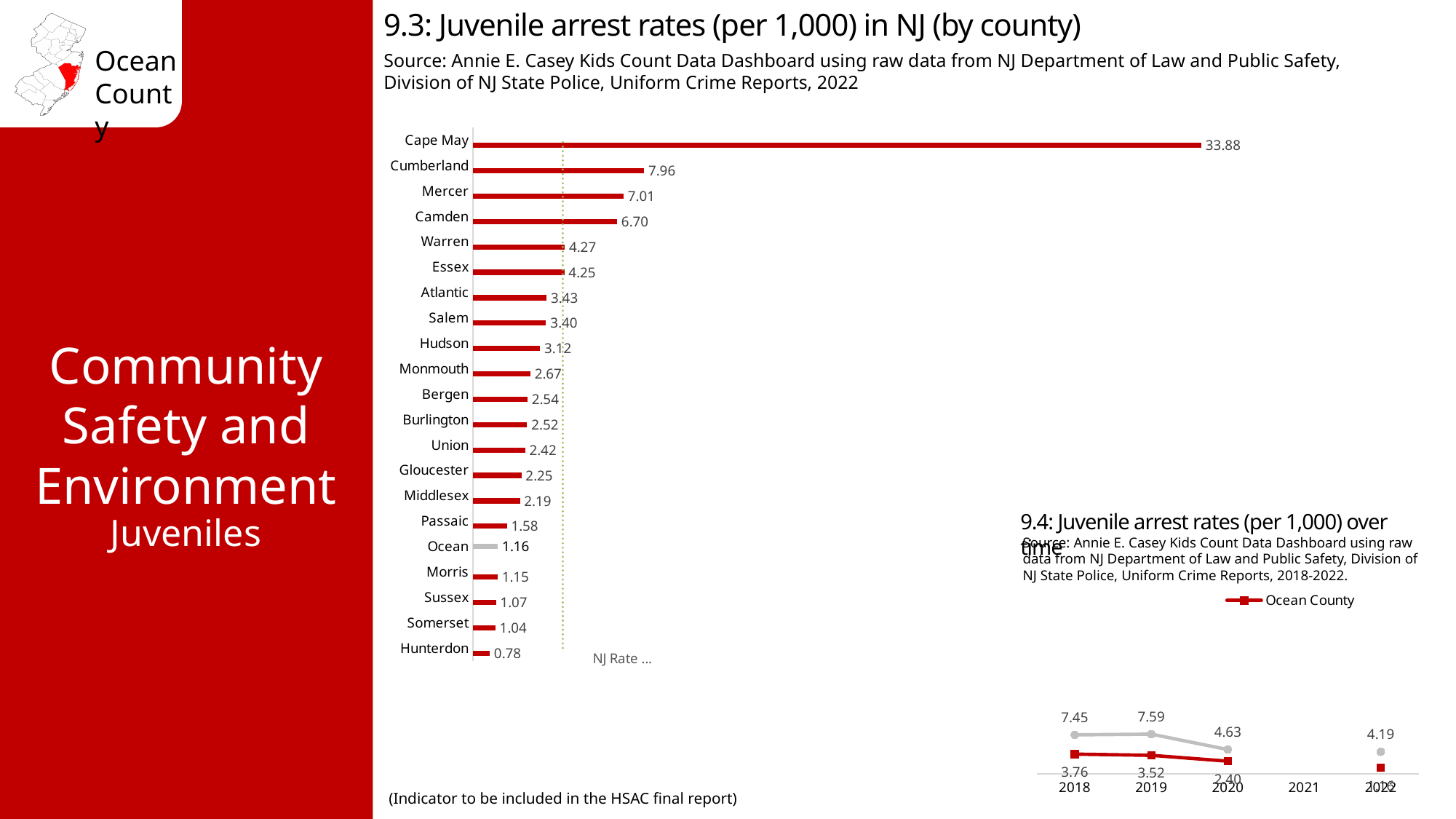
In chart 9.3 (Juvenile arrest rates by county), which county has the highest juvenile arrest rate? Cape May What kind of chart is chart 9.3 (Juvenile arrest rates by county)? Bar chart In chart 9.3 (Juvenile arrest rates by county), which county has the lowest juvenile arrest rate? Hunterdon In chart 9.4 (Juvenile arrest rates over time), does the Ocean County rate rise or fall from 2018 to 2020? Fall In chart 9.3 (Juvenile arrest rates by county), what is the difference between the rates for Cumberland and Mercer? 0.95 In chart 9.3 (Juvenile arrest rates by county), what is the juvenile arrest rate for Ocean? 1.16 In chart 9.4 (Juvenile arrest rates over time), what is the difference between the Ocean County values for 2019 and 2020? 1.12 In chart 9.3 (Juvenile arrest rates by county), how many counties are plotted? 21 In chart 9.4 (Juvenile arrest rates over time), what is the Ocean County value for 2018? 3.76 In chart 9.3 (Juvenile arrest rates by county), what is the juvenile arrest rate for Cape May? 33.88 In chart 9.3 (Juvenile arrest rates by county), what is the juvenile arrest rate for Passaic? 1.58 In chart 9.3 (Juvenile arrest rates by county), which has a higher juvenile arrest rate, Camden or Warren? Camden